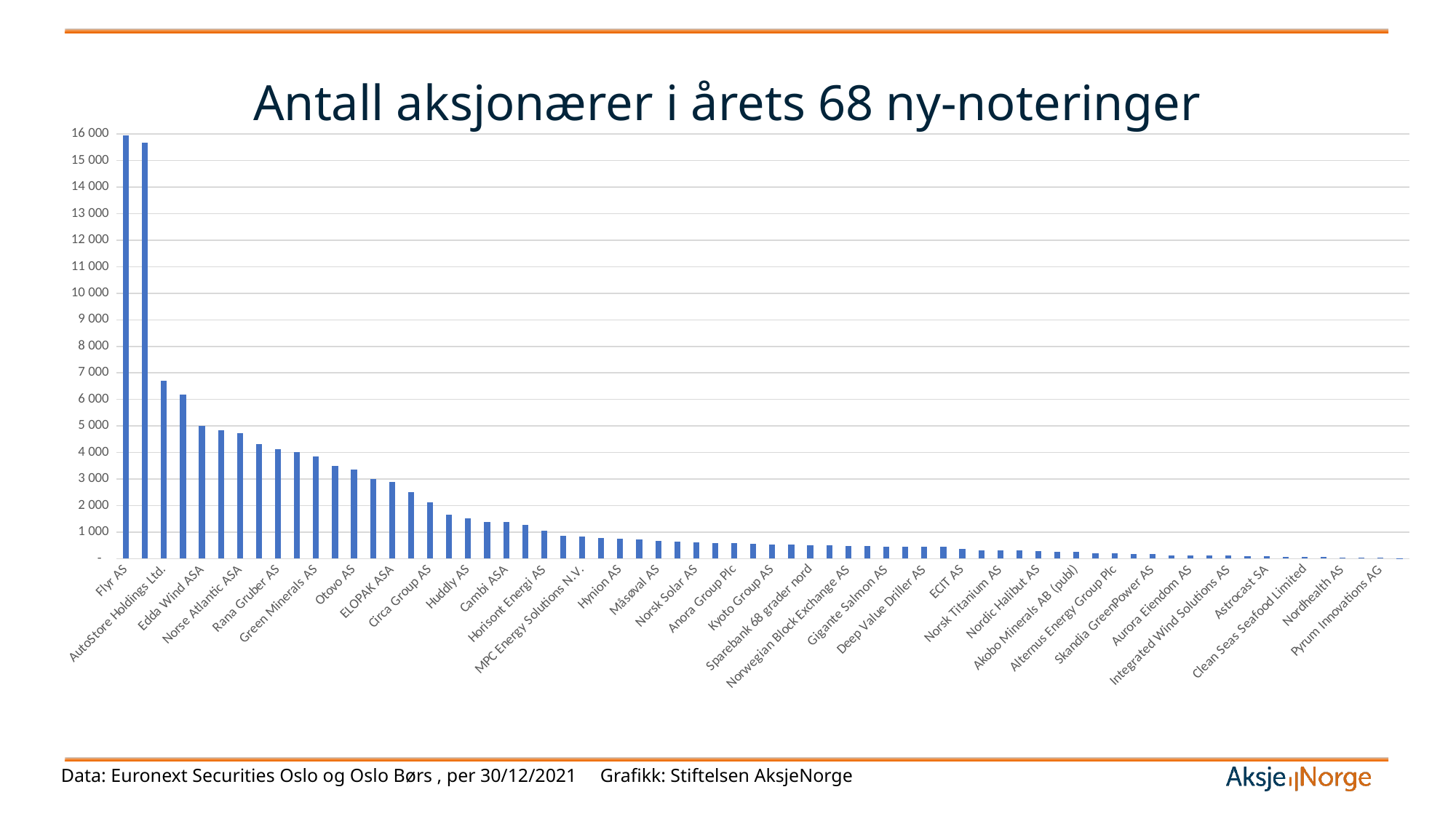
Is the value for Otovo AS greater or less than 3 000? greater Is the value for MPC Energy Solutions N.V. greater or less than 1 000? less What is the title of the chart? Antall aksjonærer i årets 68 ny-noteringer Do the values rise or fall moving from left to right along the x axis? fall What kind of chart is shown on the slide? bar chart Which has more shareholders, Huddly AS or Hynion AS? Huddly AS Which has more shareholders, Edda Wind ASA or Otovo AS? Edda Wind ASA Is the value for Edda Wind ASA greater or less than 7 000? less How many new listings (bars) does the chart cover, according to its title? 68 Which has more shareholders, Norse Atlantic ASA or Green Minerals AS? Norse Atlantic ASA